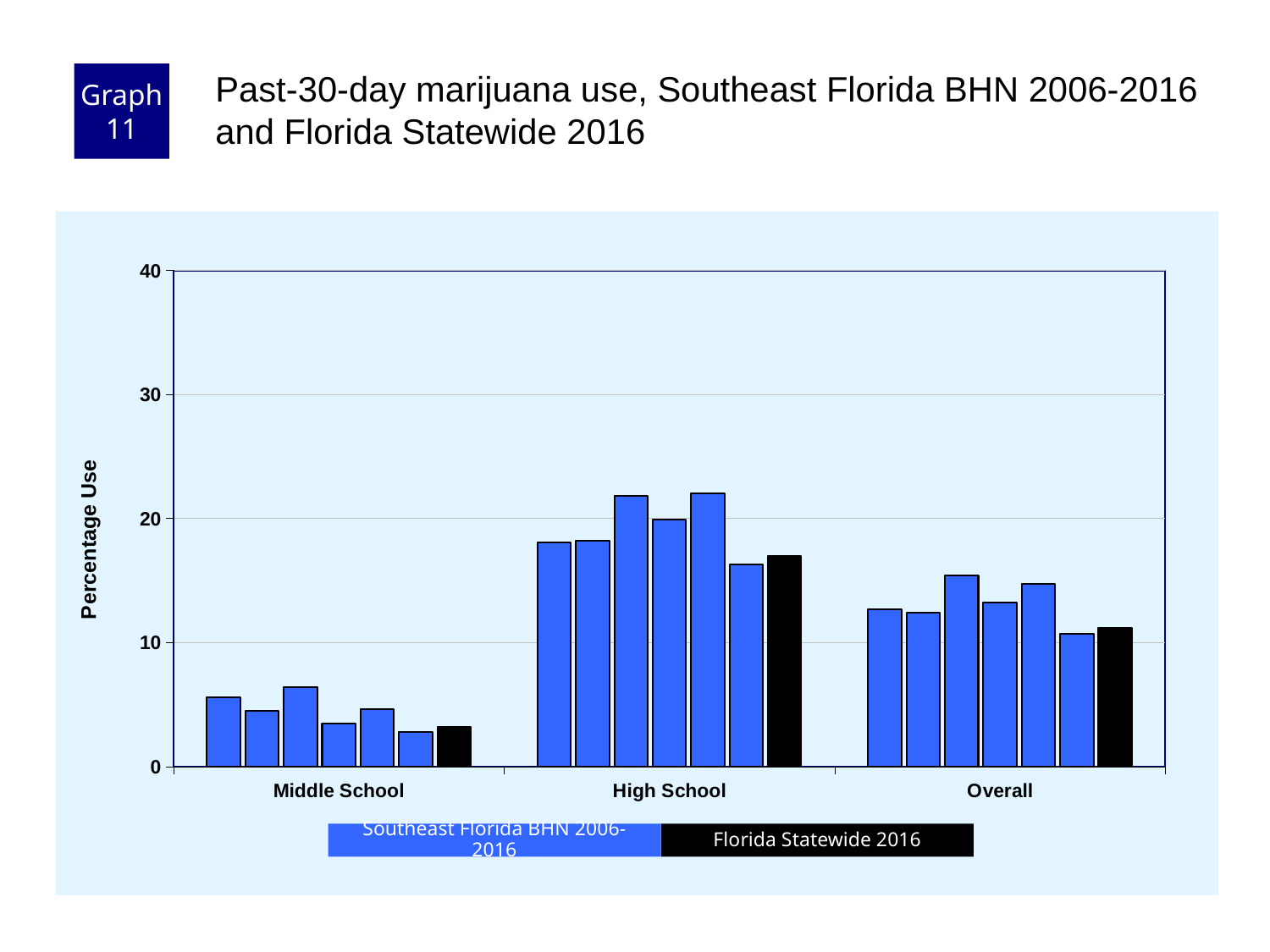
Which category has the highest bars overall? High School How many categories are shown on the x axis? 3 What kind of chart is shown on the slide? bar chart Is the Florida Statewide 2016 value for Overall greater or less than 20? less Is the Florida Statewide 2016 value for Middle School greater or less than 10? less Is the Florida Statewide 2016 value for High School greater or less than 20? less How many series does the legend list? 2 Which category has the lowest bars overall? Middle School What colour are the Florida Statewide 2016 bars? black What is the label on the y axis? Percentage Use Which is larger, the Florida Statewide 2016 value for High School or for Middle School? High School